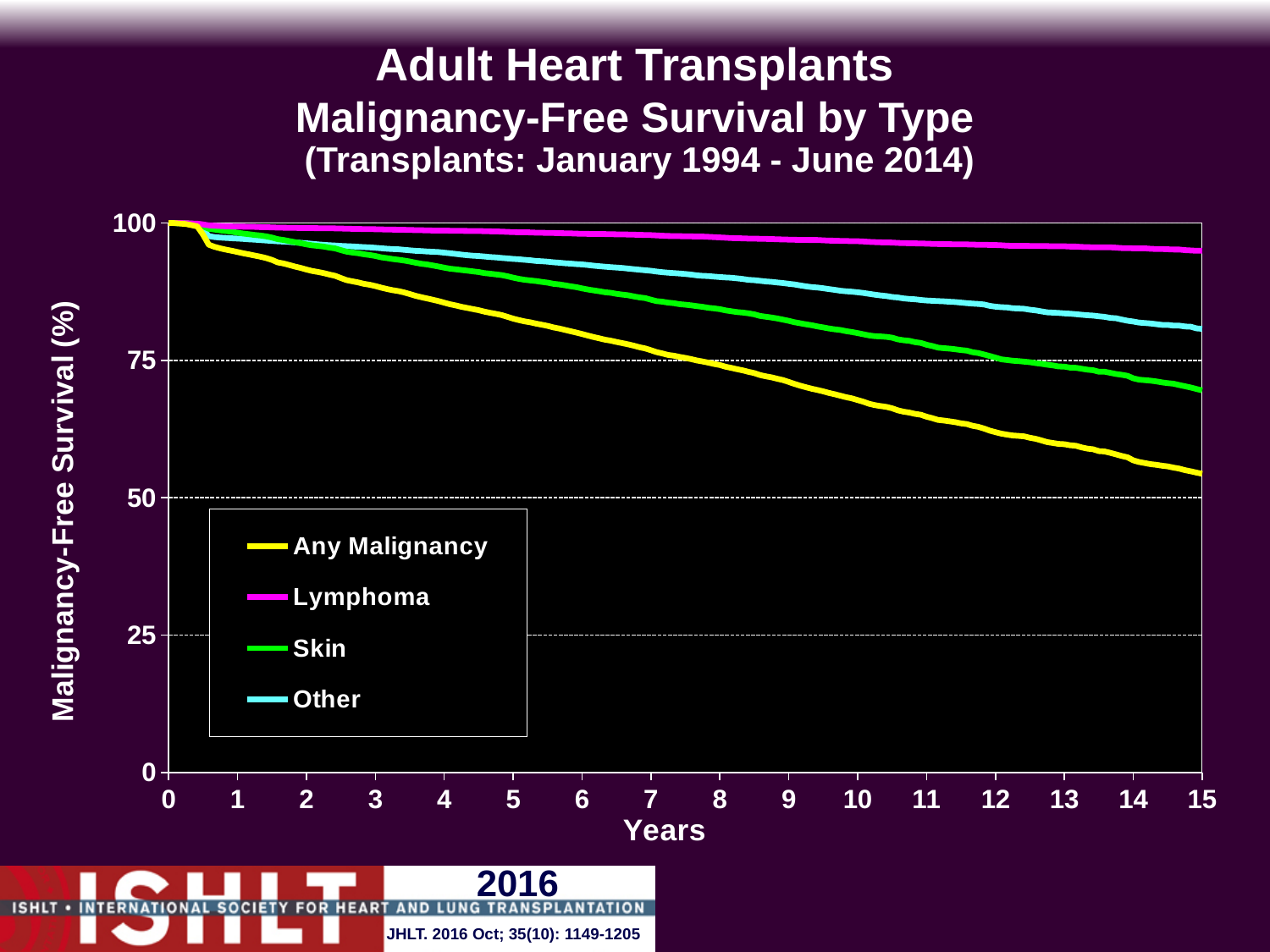
Is the value for Lymphoma at 15 years greater or less than 75? greater Is the value for Any Malignancy at 10 years greater or less than 75? less Which series has the lowest malignancy-free survival at 15 years? Any Malignancy What is the label of the y axis? Malignancy-Free Survival (%) How many series does the legend list? 4 Do the survival curves rise or fall as years increase? fall Which series has the highest malignancy-free survival at 15 years? Lymphoma At 15 years, which is higher: Skin or Lymphoma? Lymphoma Is the value for Skin at 15 years greater or less than 75? less What kind of chart is shown on the slide? line chart At 10 years, which is higher: Other or Any Malignancy? Other